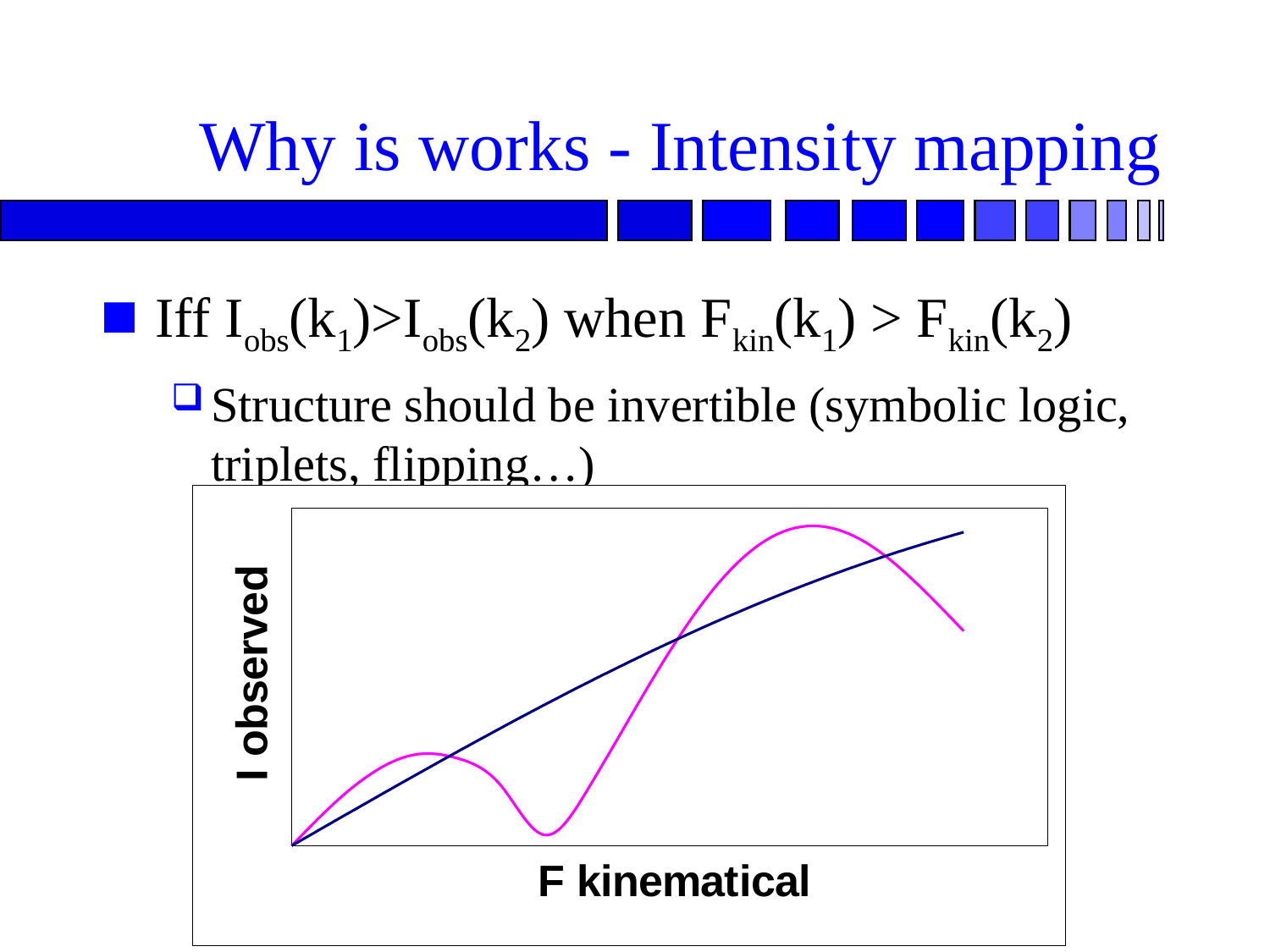
What kind of chart is shown on the slide? line chart How many lines are plotted on the chart? 2 What is the label of the x axis of the chart? F kinematical Does the magenta line rise or fall over the rightmost part of the x axis? fall Does the dark blue line rise or fall as F kinematical increases? rise What is the label of the y axis of the chart? I observed Does the chart show a legend? no